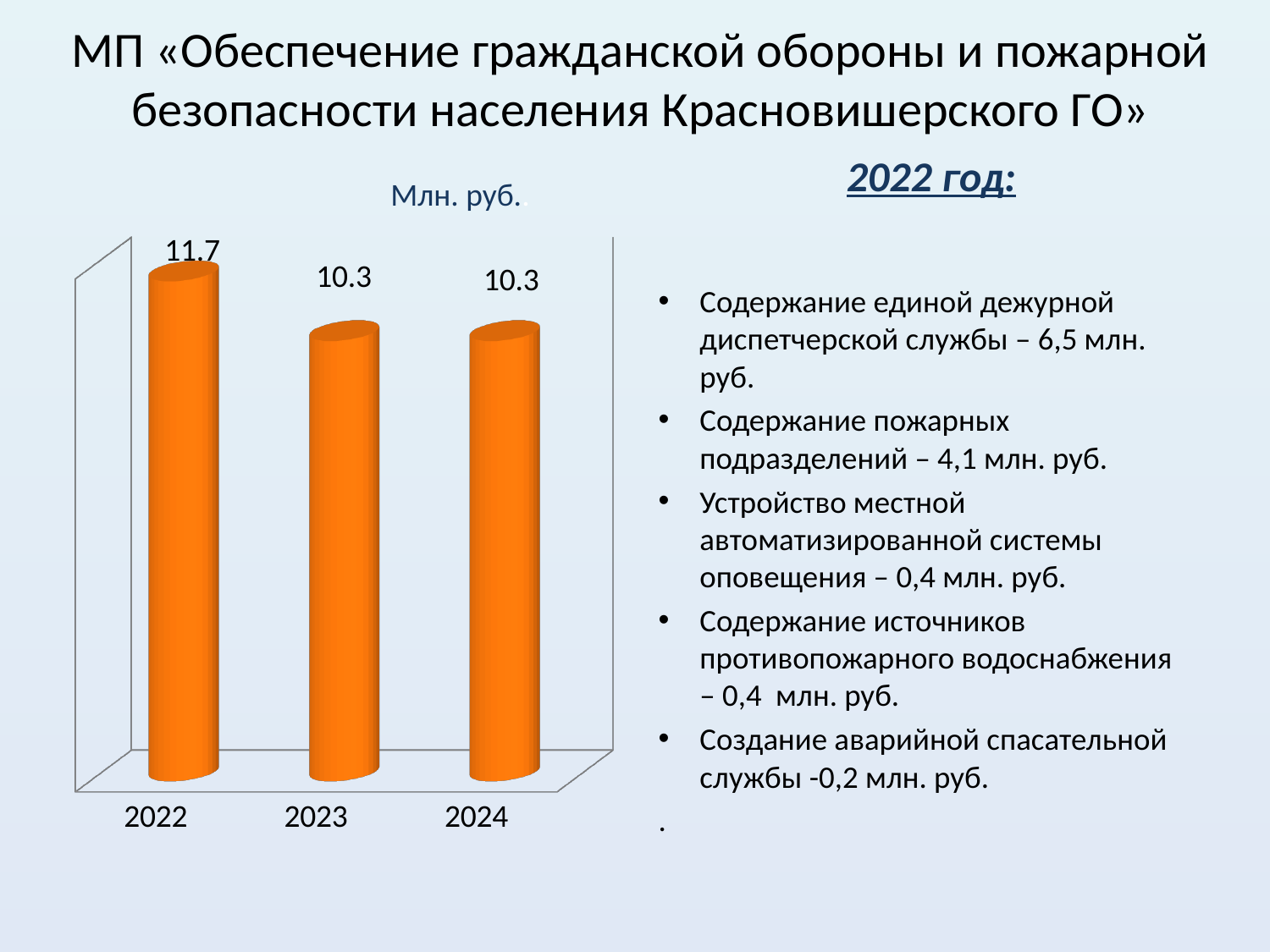
What is the value for 2024 on the chart? 10.3 What is the value for 2023 on the chart? 10.3 Are the values for 2023 and 2024 equal? yes How many years are shown on the chart? 3 What colour are the bars on the chart? orange Do the values rise or fall from 2022 to 2023? fall What kind of chart is shown on the slide? bar chart Which is larger, the value for 2022 or the value for 2024? 2022 What is the title of the chart? Млн. руб. What is the value for 2022 on the chart? 11.7 Which year has the highest value on the chart? 2022 What is the difference between the values for 2022 and 2023? 1.4